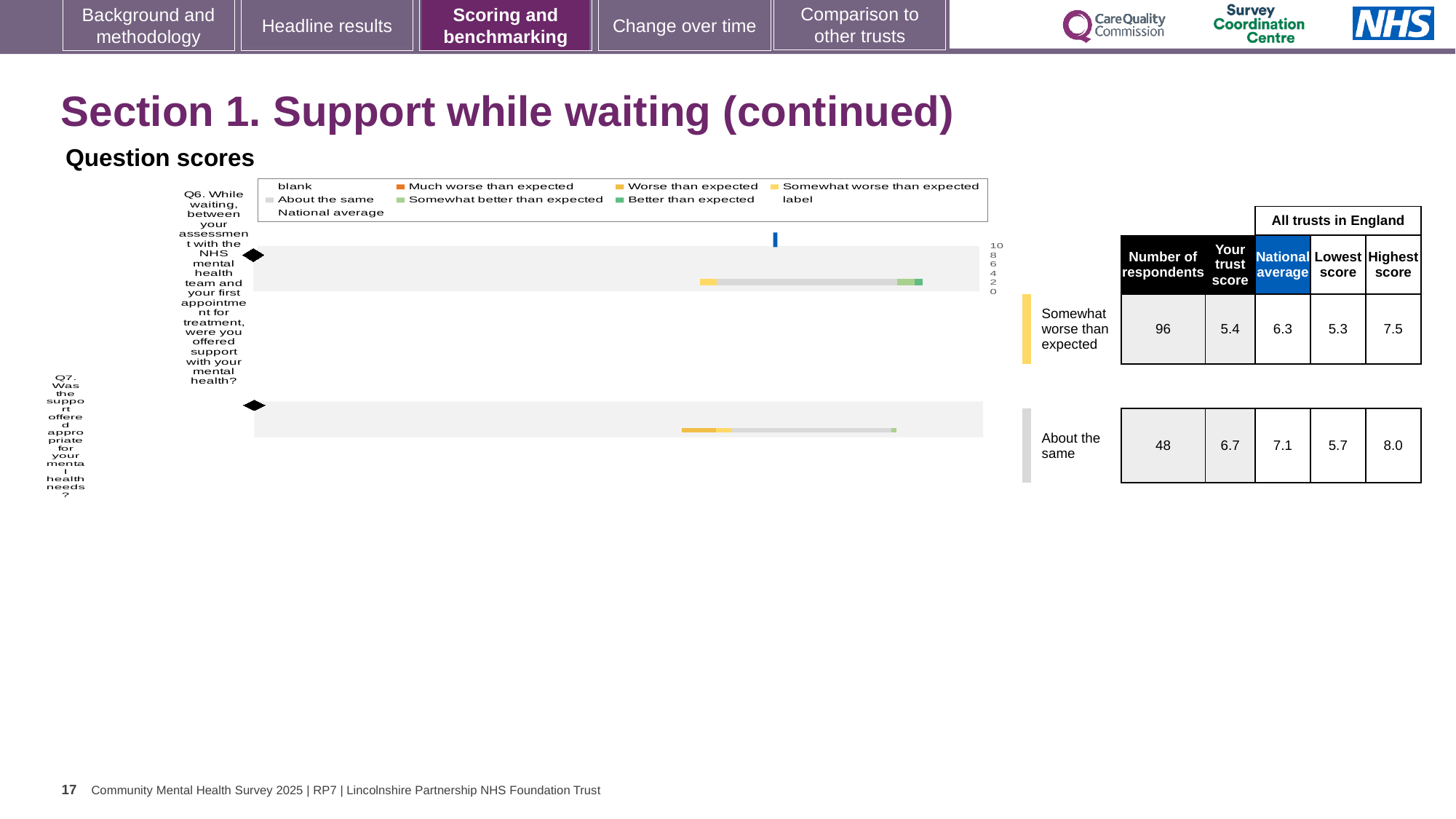
Which benchmark category is the trust's Q6 score placed in? Somewhat worse than expected Which question has the higher trust score, Q6 or Q7? Q7 What is the difference between the highest and lowest scores for Q6? 2.2 By how much is the national average for Q7 higher than the trust score for Q7? 0.4 What is the trust score for Q6 (support with mental health while waiting)? 5.4 How many questions are plotted in the chart? 2 What kind of chart is used to show the question scores? Bar chart What is the trust score for Q7 (was the support offered appropriate)? 6.7 What is the national average score for Q6? 6.3 How many respondents answered Q7? 48 Which benchmark category is the trust's Q7 score placed in? About the same What is the highest score among all trusts in England for Q6? 7.5